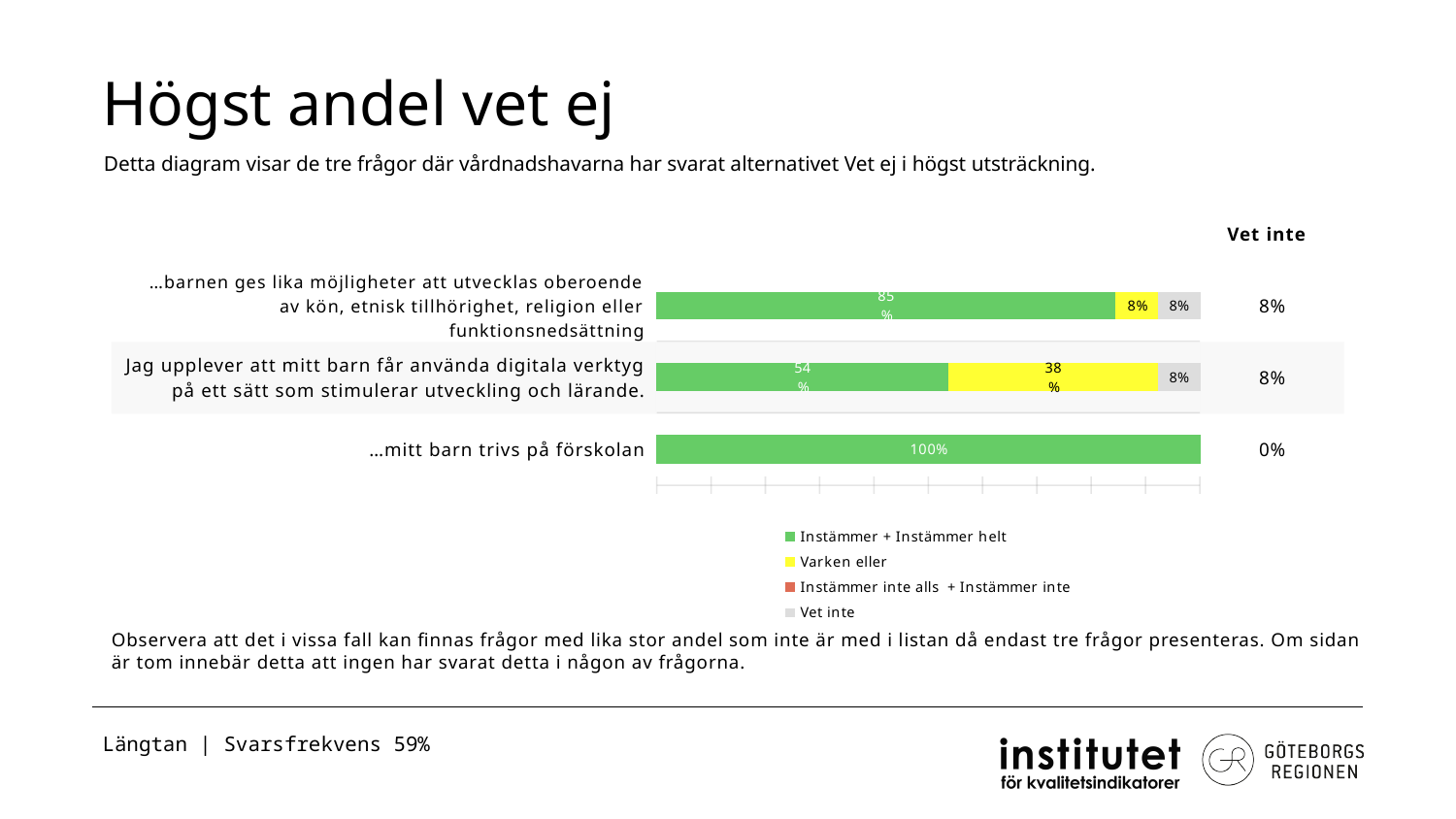
What is the 'Instämmer + Instämmer helt' value for '…barnen ges lika möjligheter att utvecklas oberoende av kön, etnisk tillhörighet, religion eller funktionsnedsättning'? 85% Which category has the highest 'Instämmer + Instämmer helt' value? …mitt barn trivs på förskolan Which category has the lowest 'Instämmer + Instämmer helt' value? Jag upplever att mitt barn får använda digitala verktyg på ett sätt som stimulerar utveckling och lärande. What is the 'Varken eller' value for 'Jag upplever att mitt barn får använda digitala verktyg på ett sätt som stimulerar utveckling och lärande.'? 38% What is the 'Instämmer + Instämmer helt' value for '…mitt barn trivs på förskolan'? 100% How many categories (questions) are plotted in the chart? 3 What is the 'Vet inte' value shown for '…mitt barn trivs på förskolan'? 0% What is the 'Instämmer + Instämmer helt' value for 'Jag upplever att mitt barn får använda digitala verktyg på ett sätt som stimulerar utveckling och lärande.'? 54% What is the difference between the 'Instämmer + Instämmer helt' values for '…barnen ges lika möjligheter att utvecklas oberoende av kön, etnisk tillhörighet, religion eller funktionsnedsättning' and 'Jag upplever att mitt barn får använda digitala verktyg på ett sätt som stimulerar utveckling och lärande.'? 31% What kind of chart is shown on the slide? Stacked bar chart Which legend entry is shown in yellow? Varken eller How many series does the legend list? 4